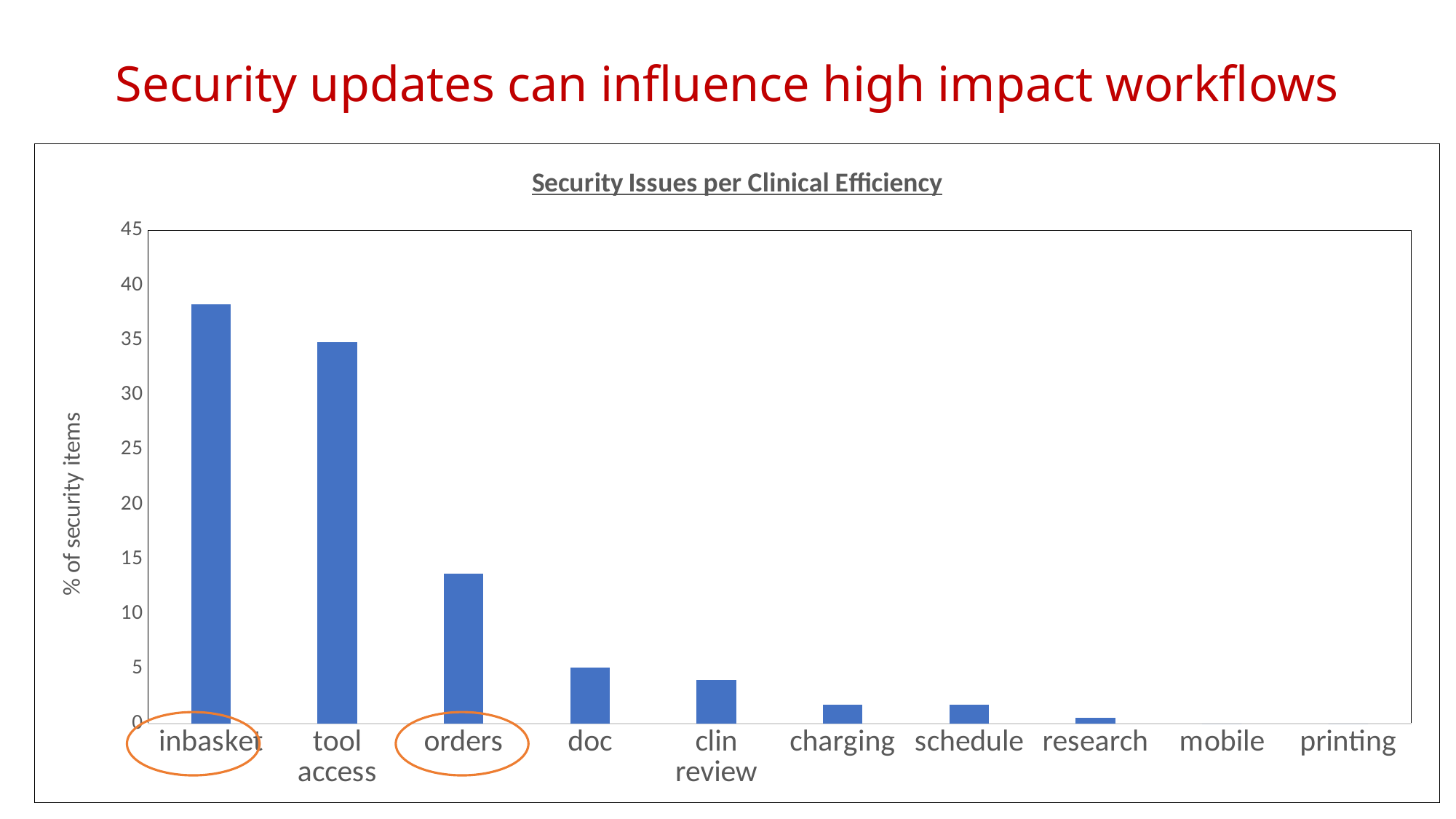
What kind of chart is shown on the slide? bar chart Do the values generally rise or fall moving from left to right along the x axis? fall Is the value for orders greater or less than 15? less Which category has the highest value in the chart? inbasket Is the value for inbasket greater or less than 35? greater Is the value for doc greater or less than 10? less What is the label on the vertical axis of the chart? % of security items What is the title of the chart? Security Issues per Clinical Efficiency Which has a larger value, inbasket or tool access? inbasket How many categories are shown on the x axis of the chart? 10